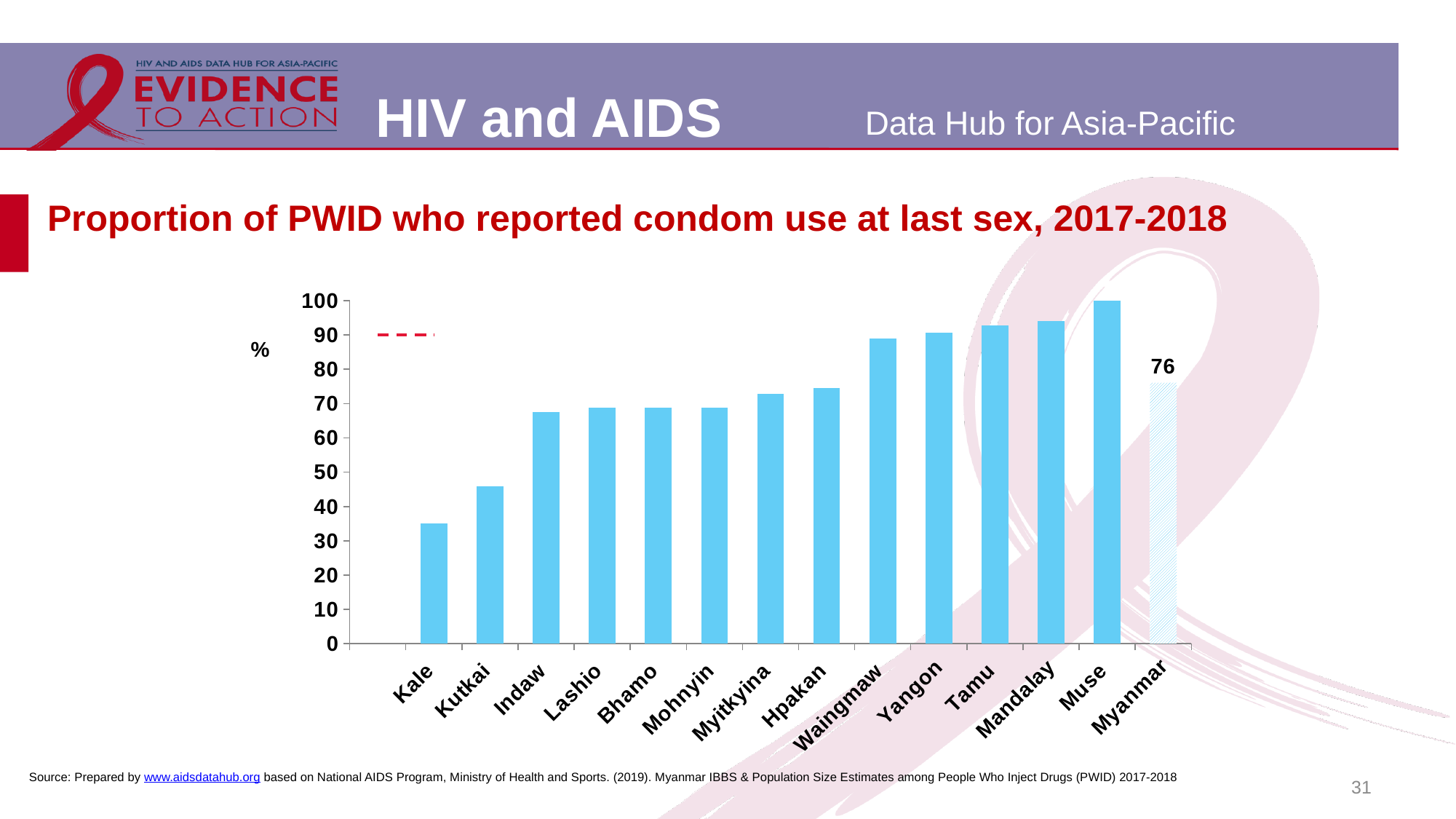
Is the value for Waingmaw greater or less than 80? greater Which category has the lowest bar? Kale What is the value shown for Myanmar? 76 How many categories are plotted along the x axis? 14 What is the title of the chart? Proportion of PWID who reported condom use at last sex, 2017-2018 Is the value for Mandalay greater or less than 90? greater Is the value for Kutkai greater or less than 50? less Do the bar values generally rise or fall from left to right across the sites? rise Which category has the highest bar? Muse What kind of chart is shown on the slide? Bar chart Which is larger, the value for Kutkai or the value for Indaw? Indaw